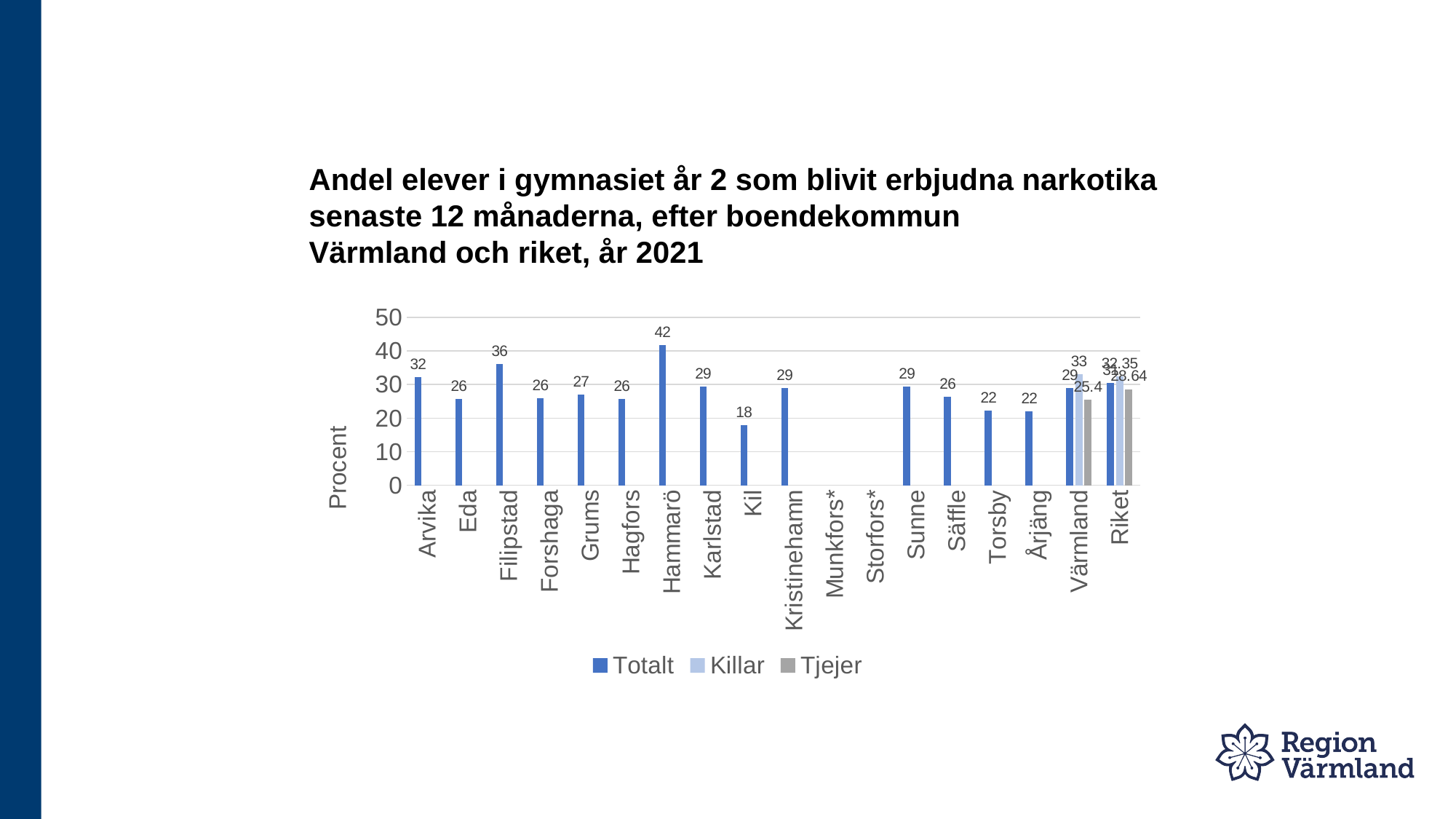
How many series does the legend list? 3 What is the Killar value for Riket? 32.35 What kind of chart is shown on the slide? bar chart What is the Totalt value for Hammarö? 42 What is the Tjejer value for Värmland? 25.4 Which has a higher Totalt value, Filipstad or Arvika? Filipstad Which municipality has the lowest Totalt value among those with a plotted bar? Kil What is the Killar value for Värmland? 33 What is the label on the vertical axis? Procent How many categories are listed on the x axis? 18 Which municipality has the highest Totalt value? Hammarö What is the difference between the Totalt values for Hammarö and Kil? 24